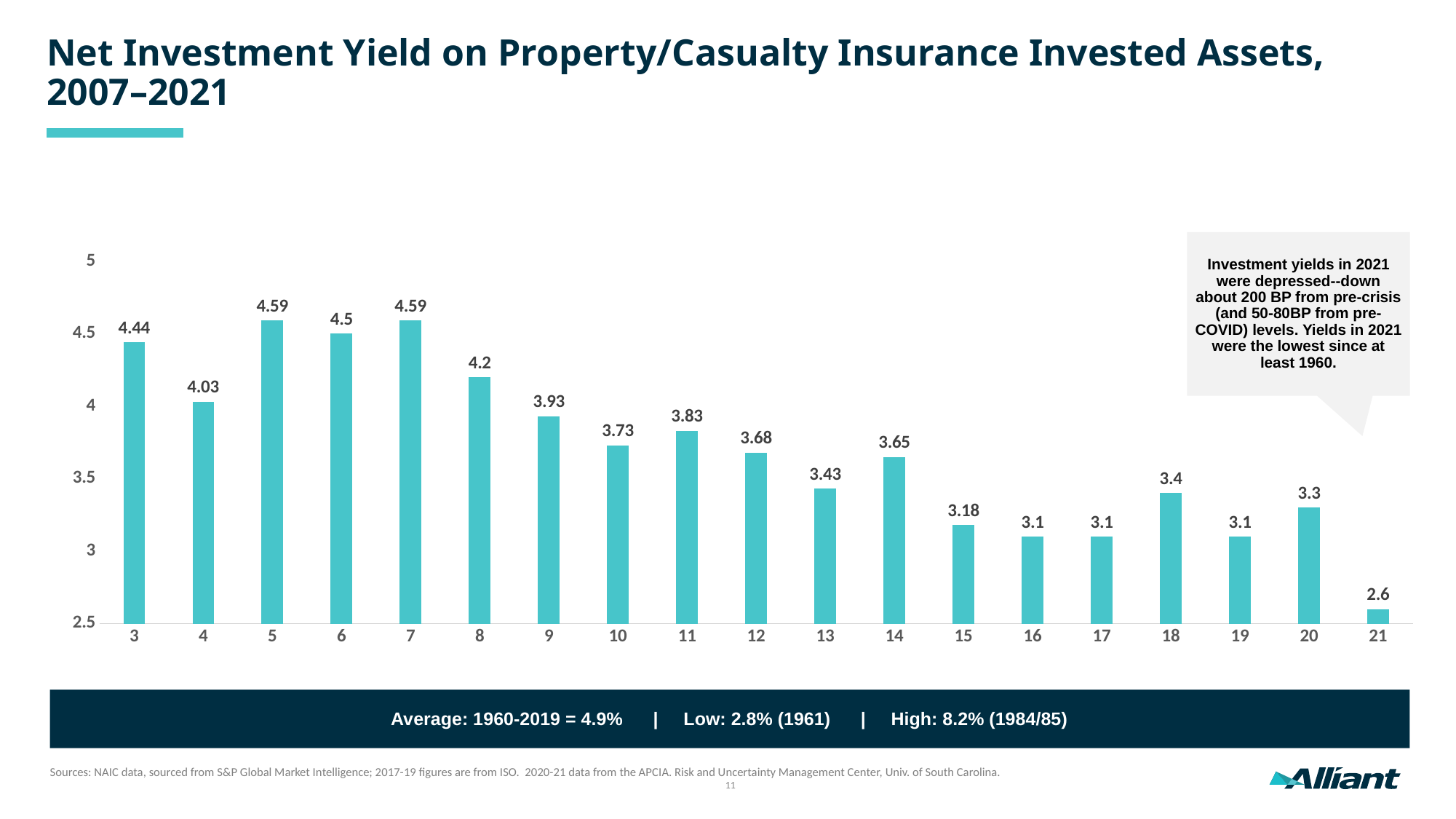
What is the difference between the values for categories 18 and 19? 0.3 What is the value of the bar labelled 3 on the x axis? 4.44 What kind of chart is shown on the slide? Bar chart What is the difference between the values for categories 3 and 21? 1.84 Which is larger, the value for category 11 or the value for category 10? 11 Is the value for category 15 greater or less than 3? greater What is the value of the bar labelled 21 on the x axis? 2.6 What is the highest value shown on the chart? 4.59 What is the value of the bar labelled 13 on the x axis? 3.43 How many bars are plotted on the chart? 19 Which x-axis category has the lowest value? 21 Do the values generally rise or fall from left to right along the x axis? Fall